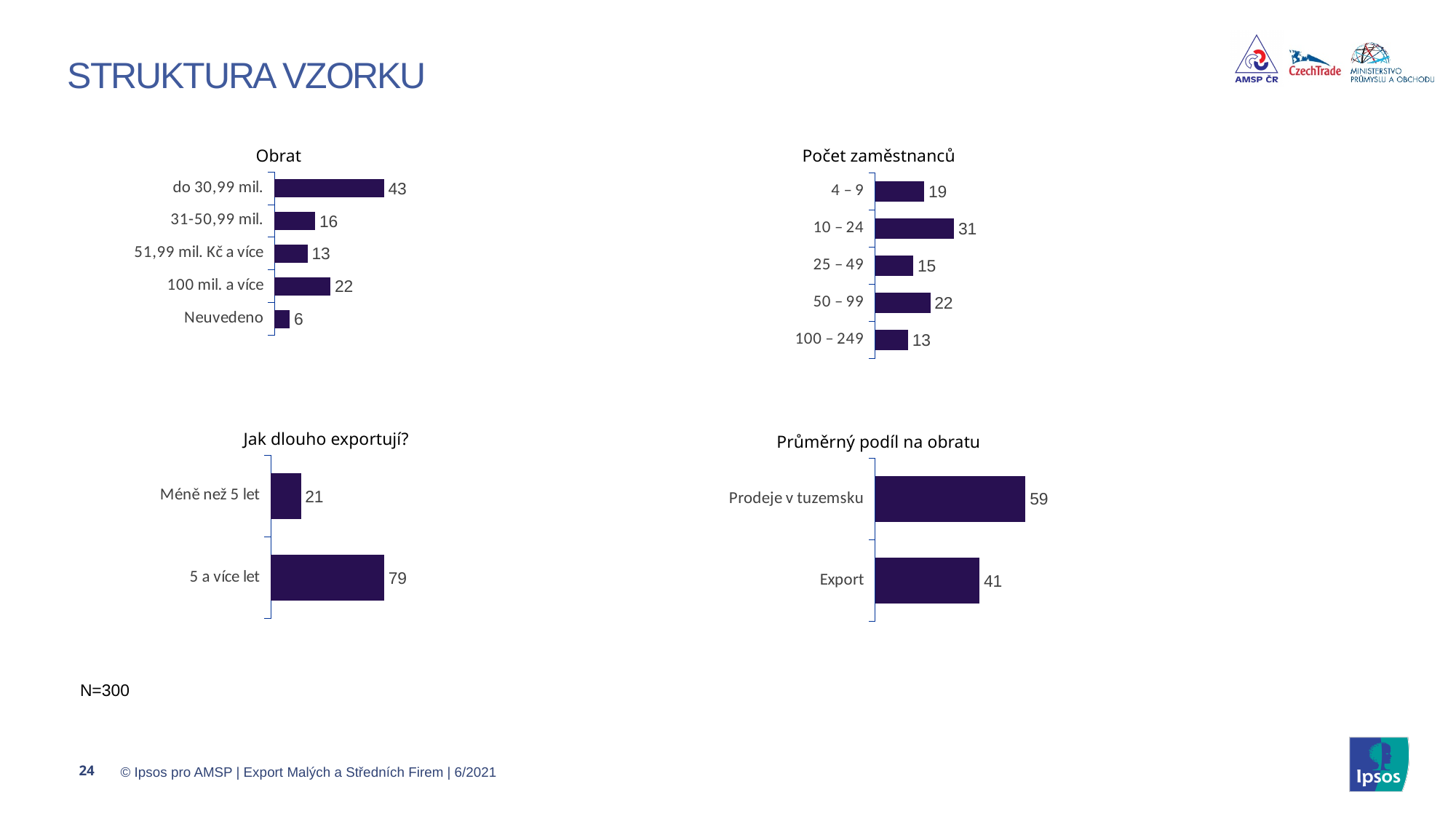
How many categories does the "Počet zaměstnanců" chart show? 5 In the "Průměrný podíl na obratu" chart, what is the value for "Export"? 41 In the "Počet zaměstnanců" chart, what is the value for "50 – 99"? 22 In the "Obrat" chart, which category has the lowest value? Neuvedeno In the "Obrat" chart, what is the difference between "100 mil. a více" and "31-50,99 mil."? 6 In the "Obrat" chart, what is the value for "do 30,99 mil."? 43 In the "Jak dlouho exportují?" chart, what is the difference between "5 a více let" and "Méně než 5 let"? 58 In the "Jak dlouho exportují?" chart, what is the value for "5 a více let"? 79 How many charts are shown on the slide? 4 What type of chart is the "Průměrný podíl na obratu" chart? Bar chart In the "Počet zaměstnanců" chart, which is larger: "4 – 9" or "25 – 49"? 4 – 9 In the "Počet zaměstnanců" chart, which category has the highest value? 10 – 24